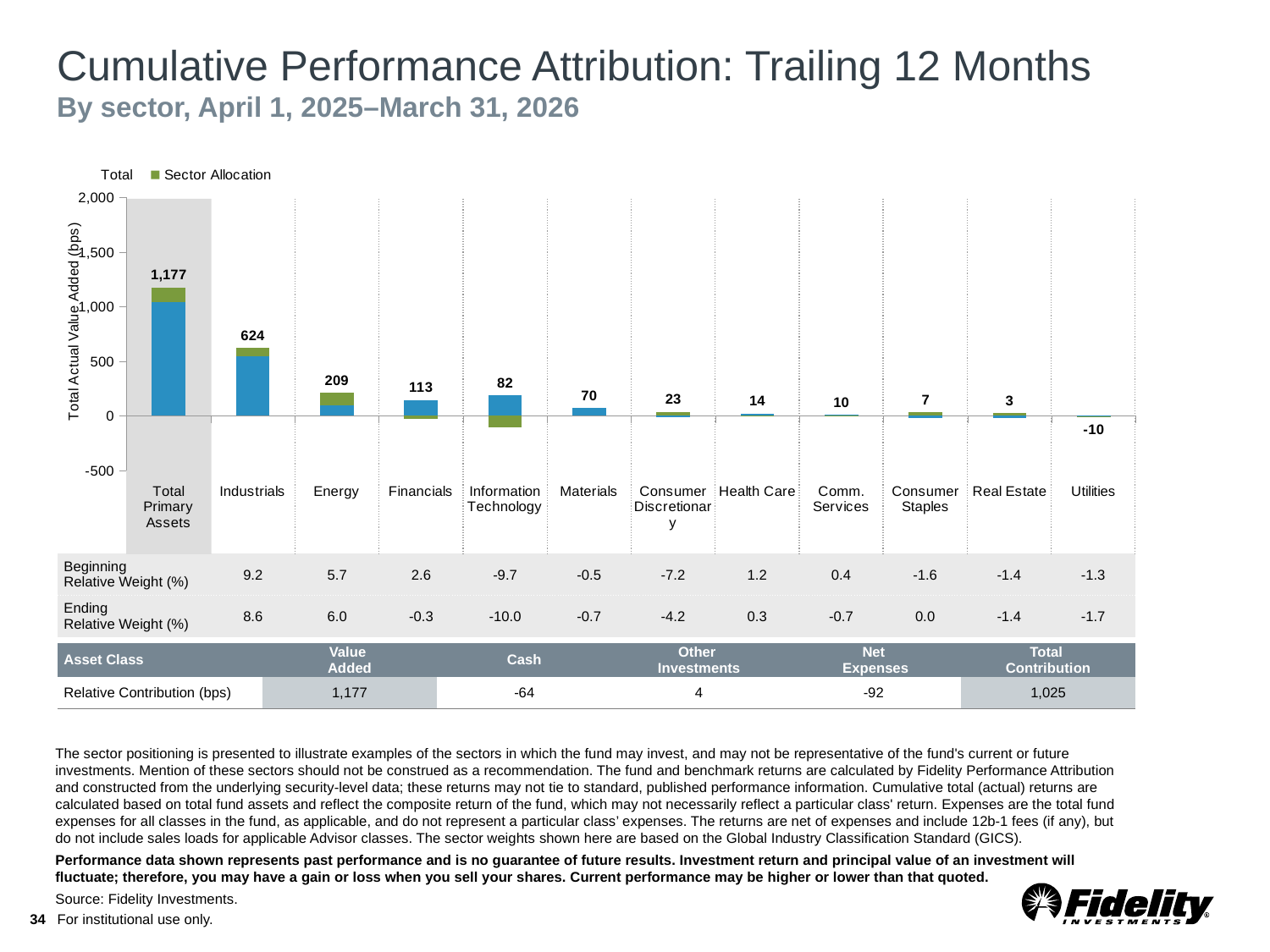
What is the total value added for Industrials? 624 Which has a larger total value added, Financials or Materials? Financials What is the difference between the total value added for Industrials and Energy? 415 What is the total value added for Information Technology? 82 Excluding Total Primary Assets, which sector has the highest total value added? Industrials What is the total value added for Utilities? -10 How many series does the chart legend list? 2 Is the value for Industrials greater or less than 500? greater How many categories are shown on the x axis of the chart? 12 What kind of chart is shown on the slide? Bar chart Which category has the lowest total value added? Utilities What is the total value added for Total Primary Assets? 1,177